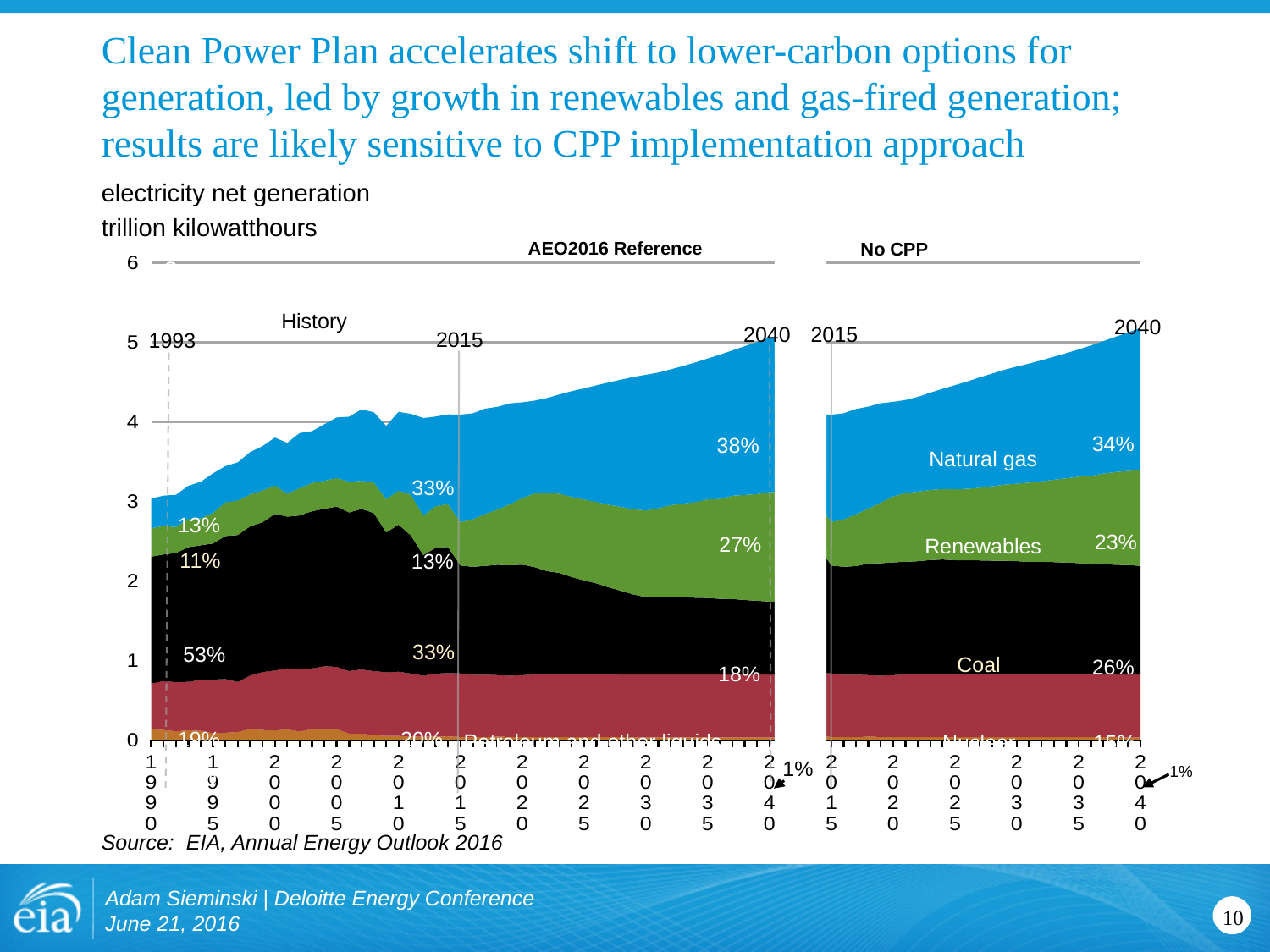
In the No CPP chart, what share of generation does coal account for in 2040? 26% What kind of chart is used to show electricity net generation on this slide? Stacked area chart In the AEO2016 Reference chart, what share of electricity net generation does natural gas account for in 2040? 38% In the AEO2016 Reference chart, what is the difference between the coal share in 1993 and the coal share in 2040? 35 percentage points In the AEO2016 Reference chart, what share of generation does coal account for in 2040? 18% In 2040, is the coal share of generation larger in the AEO2016 Reference chart or in the No CPP chart? No CPP What unit is electricity net generation measured in on this slide? trillion kilowatthours In the AEO2016 Reference chart, what share of generation did coal account for in 1993? 53% In the AEO2016 Reference chart, what share of generation do renewables account for in 2040? 27% In the No CPP chart, what share of generation does natural gas account for in 2040? 34% In the AEO2016 Reference chart, what share of generation did natural gas account for in 2015? 33% In the No CPP chart, what share of generation does nuclear account for in 2040? 15%